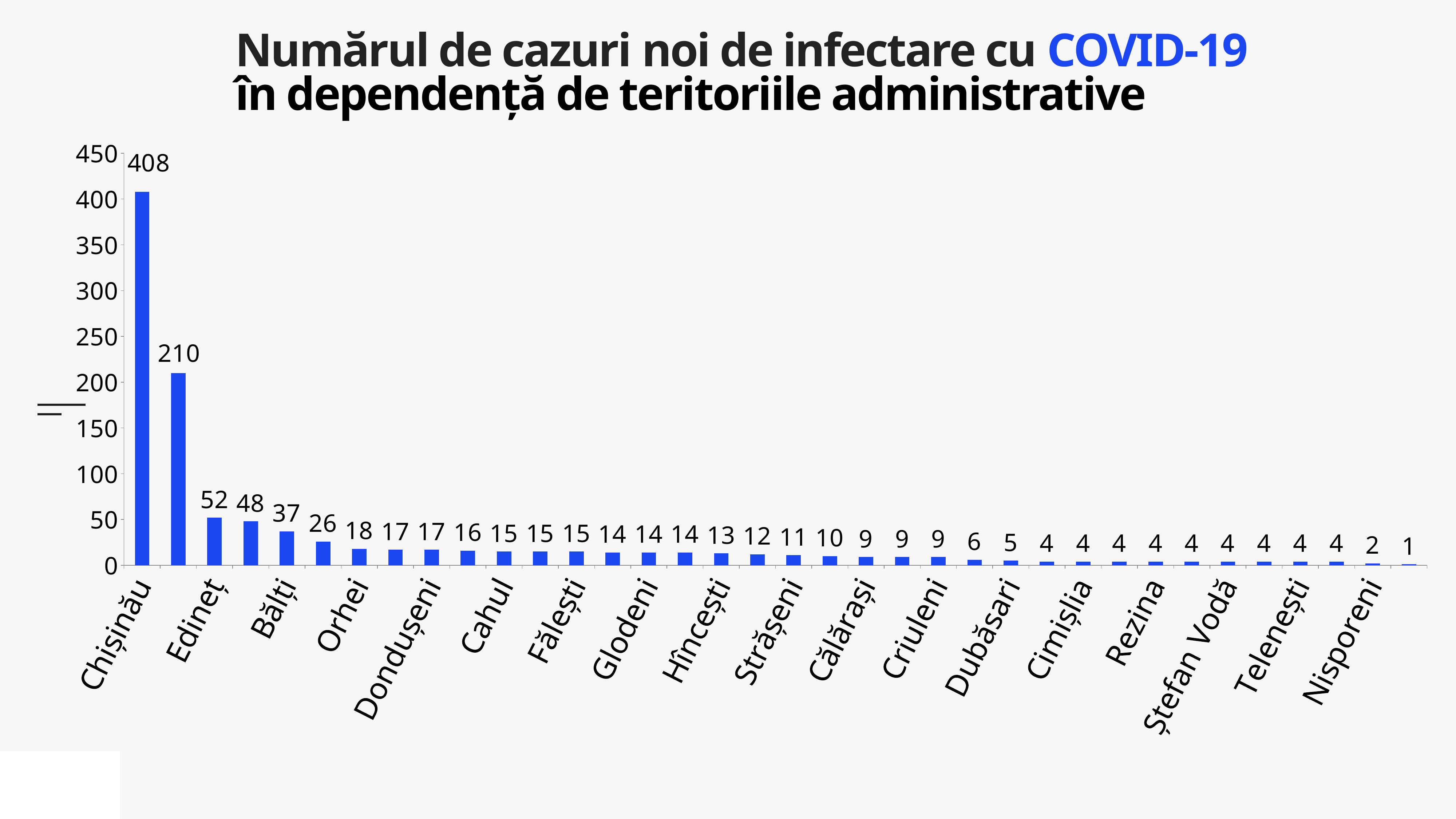
Do the values rise or fall moving from left to right along the x axis? fall Which administrative territory has the highest number of new COVID-19 cases? Chișinău Is the value for Chișinău greater or less than 400? greater What is the smallest value shown in the chart? 1 How many bars have a data label of 4? 9 How many bars are plotted in the chart? 36 How many new COVID-19 cases are shown for Chișinău? 408 Which is larger, the value for Chișinău or the value for Edineț? Chișinău What is the second-highest value shown in the chart? 210 What is the difference between the two tallest bars (408 and 210)? 198 What type of chart is shown on the slide? bar chart What colour are the bars in the chart? blue